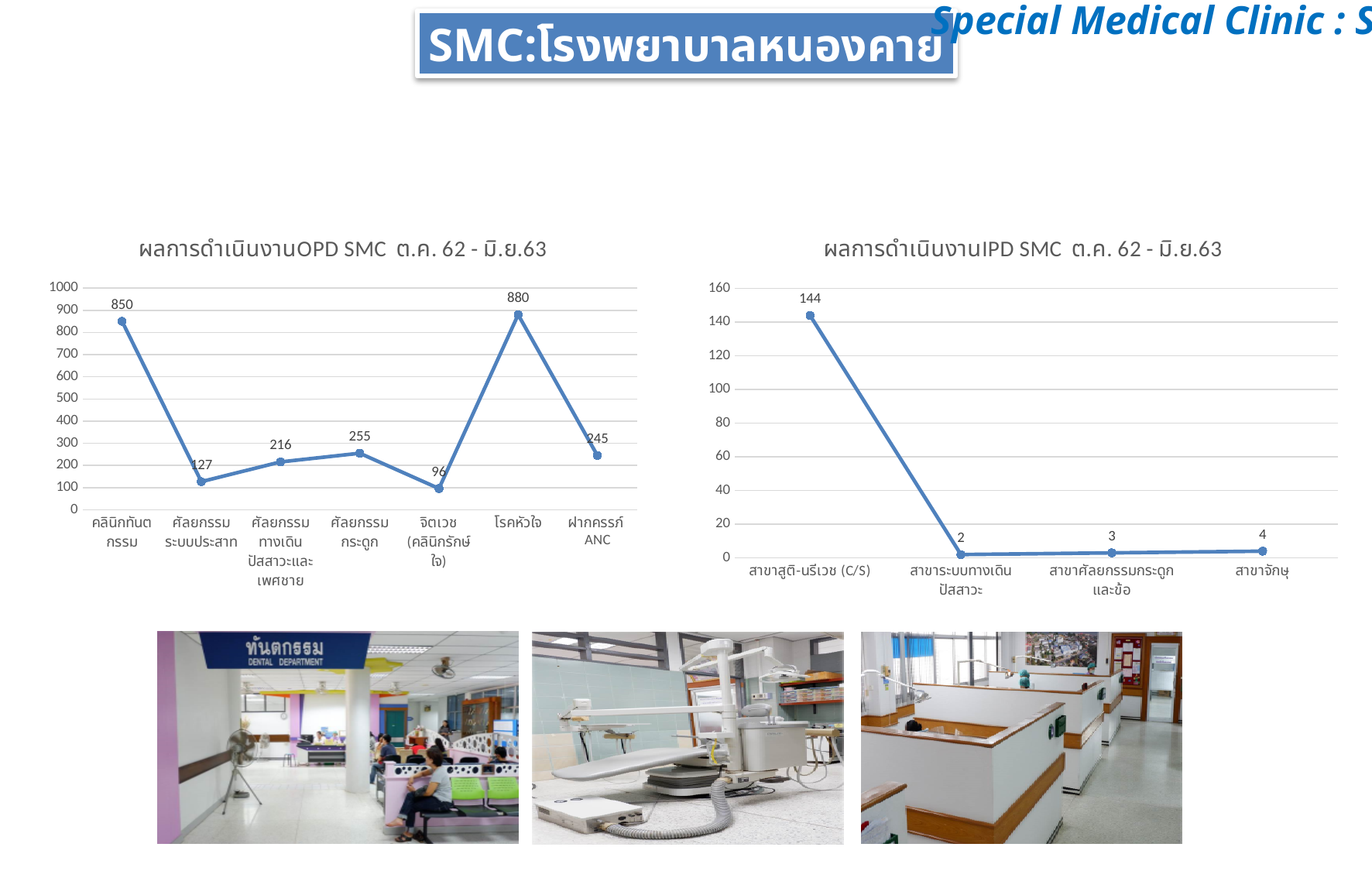
In the IPD SMC chart (right), what is the difference between the values for สาขาจักษุ and สาขาศัลยกรรมกระดูกและข้อ? 1 In the OPD SMC chart (left), what is the value for ศัลยกรรมระบบประสาท? 127 How many categories are plotted in the OPD SMC chart (left)? 7 What type of chart is the IPD SMC chart (right)? Line chart In the OPD SMC chart (left), which category has the lowest value? จิตเวช (คลินิกรักษ์ใจ) In the IPD SMC chart (right), what is the value for สาขาสูติ-นรีเวช (C/S)? 144 In the IPD SMC chart (right), which category has the lowest value? สาขาระบบทางเดินปัสสาวะ In the OPD SMC chart (left), which is larger: ศัลยกรรมกระดูก or ฝากครรภ์ ANC? ศัลยกรรมกระดูก In the OPD SMC chart (left), which category has the highest value? โรคหัวใจ In the OPD SMC chart (left), what is the difference between the values for โรคหัวใจ and คลินิกทันตกรรม? 30 How many categories are plotted in the IPD SMC chart (right)? 4 In the OPD SMC chart (left), what is the value for โรคหัวใจ? 880